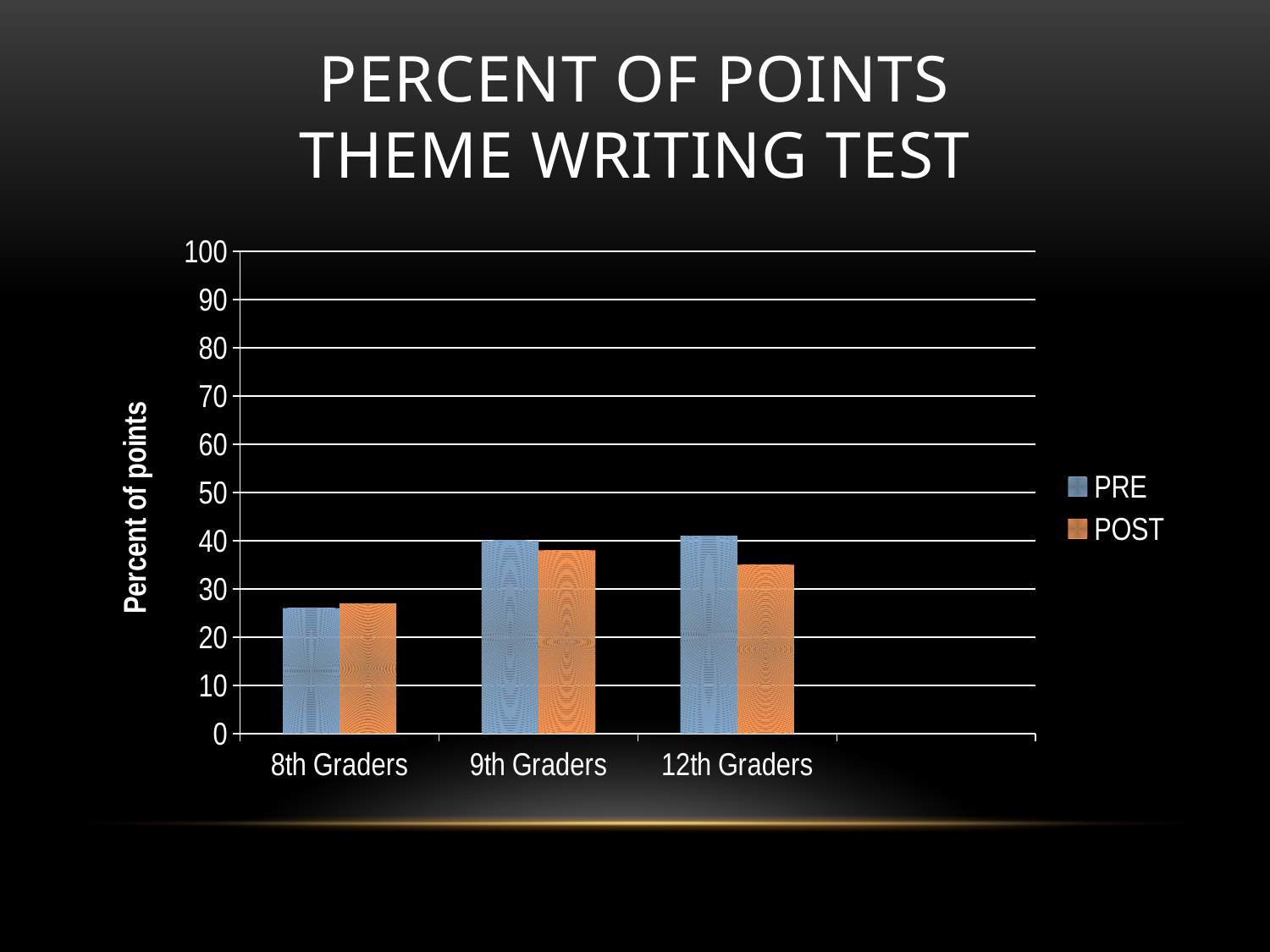
Which grade has the lowest POST value? 8th Graders Is the PRE value for 9th Graders greater or less than 30? greater Which grade has the lowest PRE value? 8th Graders Is the POST value for 12th Graders greater or less than 40? less Is the POST value for 8th Graders greater or less than 30? less What kind of chart is shown on the slide? bar chart How many grade categories are shown on the x axis? 3 For 12th Graders, which is larger, the PRE value or the POST value? PRE How many series does the legend list? 2 What is the label on the vertical axis? Percent of points